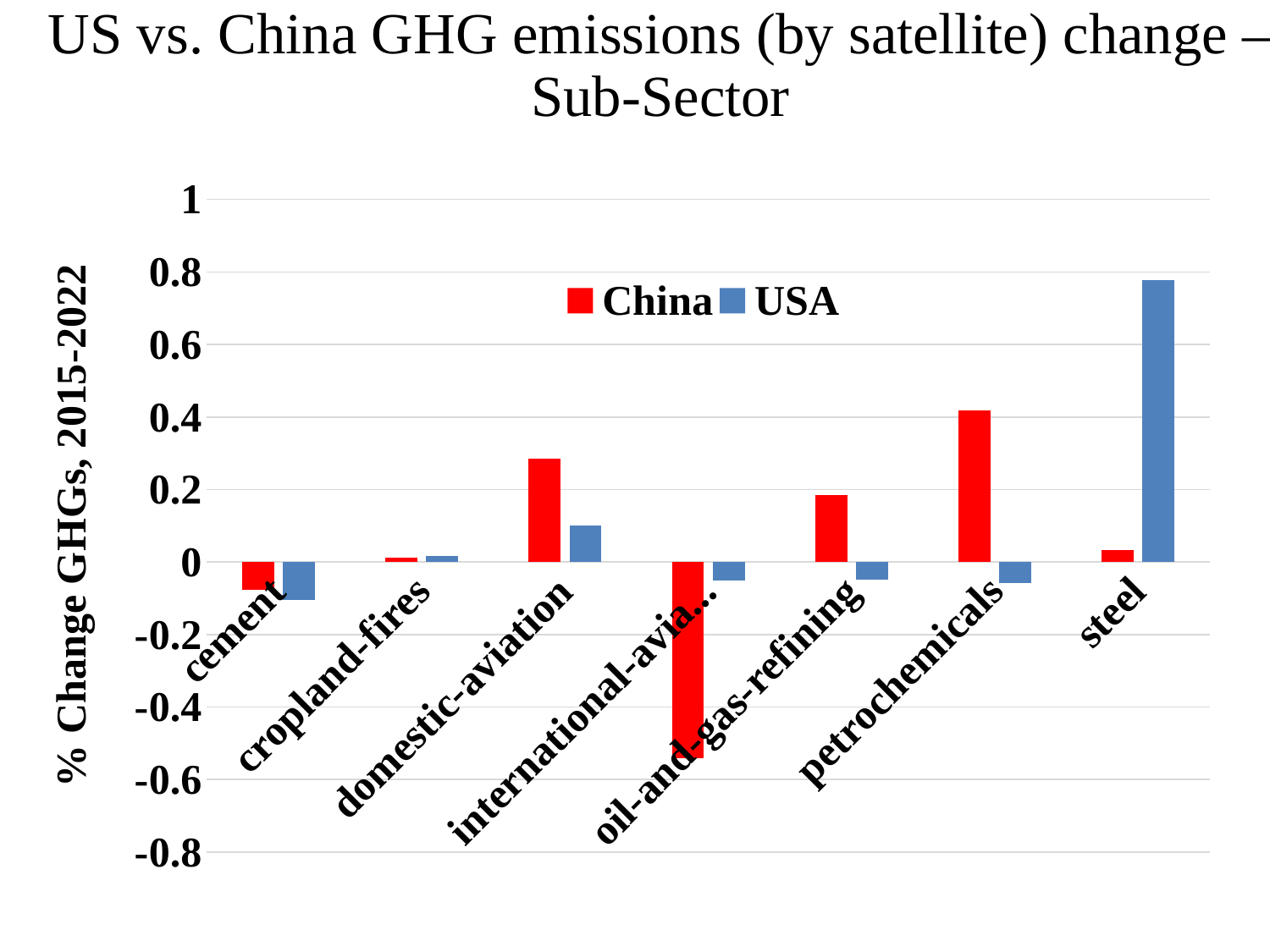
Which category has the highest China value? petrochemicals Which category has the highest USA value? steel For domestic-aviation, which series has the larger value, China or USA? China How many series does the legend list? 2 Is the China value for domestic-aviation greater or less than 0.2? greater For steel, which series has the larger value, China or USA? USA How many sub-sector categories are plotted on the x axis? 7 Is the USA value for domestic-aviation greater or less than 0.2? less Is the China value for petrochemicals greater or less than 0.2? greater What colour are the China bars? red What kind of chart is shown on the slide? bar chart